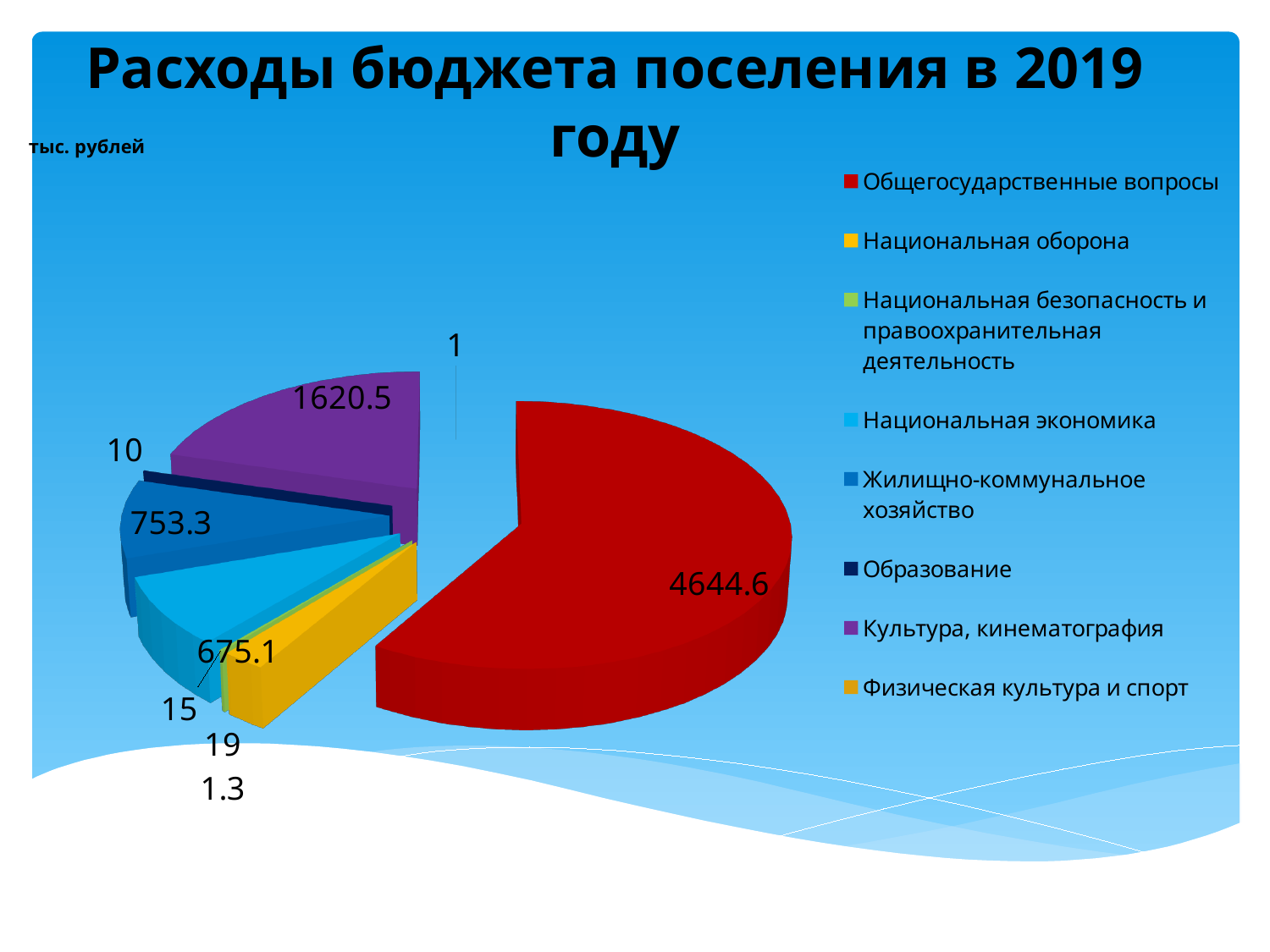
What is the difference between the values for Общегосударственные вопросы and Культура, кинематография? 3024.1 What is the difference between the values for Жилищно-коммунальное хозяйство and Национальная экономика? 78.2 In what units are the chart values given? тыс. рублей What is the value for Культура, кинематография? 1620.5 What kind of chart is shown on the slide? pie chart What is the value for Национальная экономика? 675.1 What is the title of the chart? Расходы бюджета поселения в 2019 году What is the value for Жилищно-коммунальное хозяйство? 753.3 Which category has the largest slice of the pie? Общегосударственные вопросы Which is larger: Культура, кинематография or Жилищно-коммунальное хозяйство? Культура, кинематография What is the value for Общегосударственные вопросы? 4644.6 How many entries does the legend list? 8